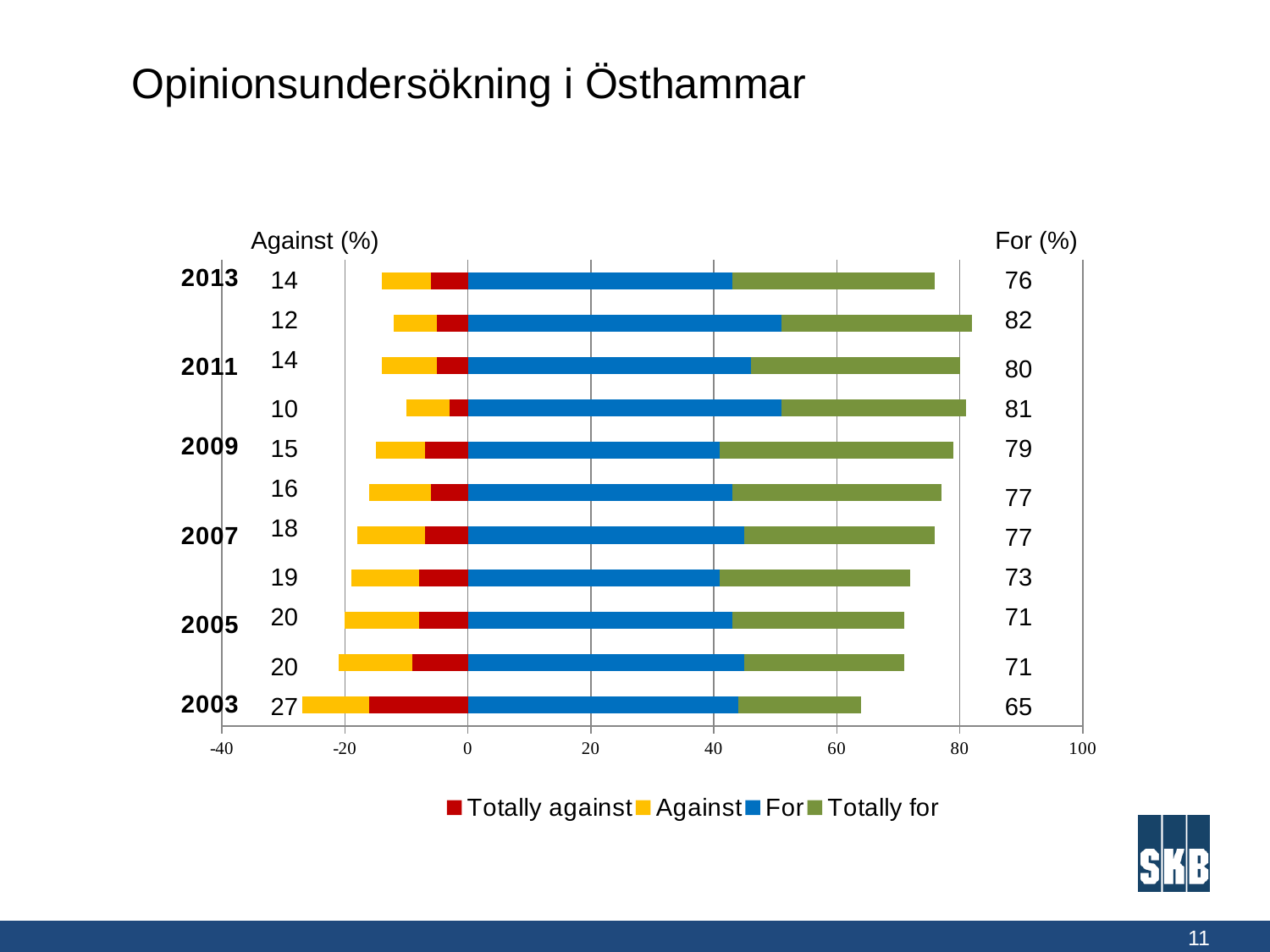
Which year has a larger Against (%) value, 2007 or 2011? 2007 How many series does the legend list? 4 Which year has the highest Against (%) value? 2003 What is the For (%) value for 2013? 76 What is the Against (%) value for 2003? 27 What kind of chart is shown on the slide? Stacked bar chart How many bars are plotted in the chart? 11 What is the For (%) value for 2005? 71 Which year has the lowest For (%) value? 2003 Which colour represents the 'Totally for' series in the legend? Green What is the difference between the For (%) value for 2013 and the For (%) value for 2003? 11 What is the difference between the Against (%) value for 2003 and the Against (%) value for 2013? 13